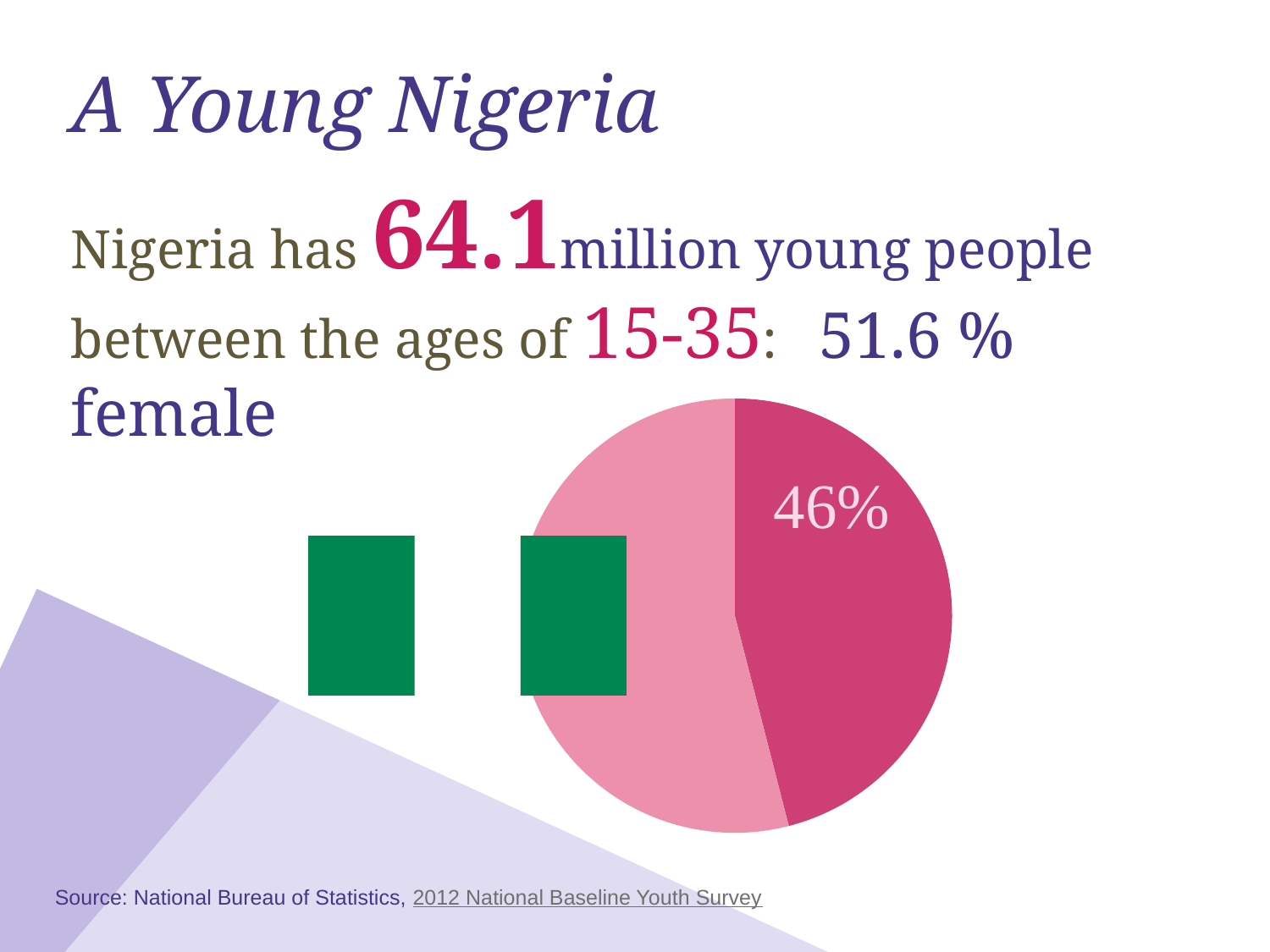
Is the slice labelled 46% greater or less than half of the pie? less What colour is the slice of the pie chart that carries the 46% label? dark pink Which slice of the pie chart is larger, the dark pink slice labelled 46% or the light pink slice? the light pink slice What kind of chart is shown on the slide? pie chart Does the pie chart have a legend? No Which slice of the pie chart is the smallest? the dark pink slice labelled 46% What share of the pie does the dark pink slice represent? 46% What percentage is printed on the labelled slice of the pie chart? 46% How many slices does the pie chart have? 2